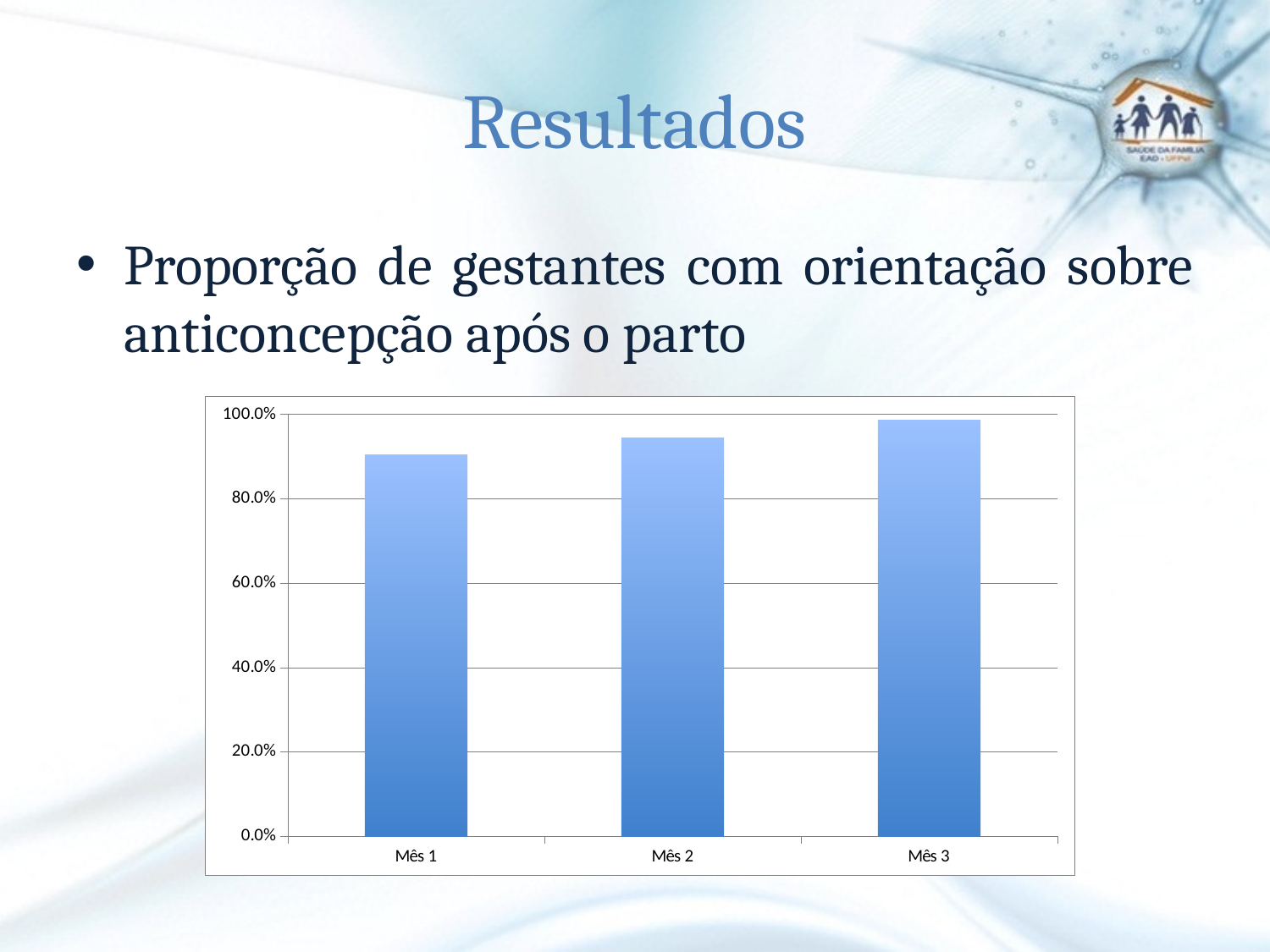
How many categories (bars) does the chart show? 3 Which is larger, the value for Mês 1 or the value for Mês 3? Mês 3 Is the value for Mês 1 greater or less than 100.0%? less Which category has the lowest value in the chart? Mês 1 Is the value for Mês 3 greater or less than 80.0%? greater What is the label of the first category on the horizontal axis? Mês 1 What kind of chart is shown on the slide? bar chart What is the highest value shown on the vertical axis of the chart? 100.0% Is the value for Mês 2 greater or less than 80.0%? greater Do the values rise or fall from Mês 1 to Mês 3? rise Which category has the highest value in the chart? Mês 3